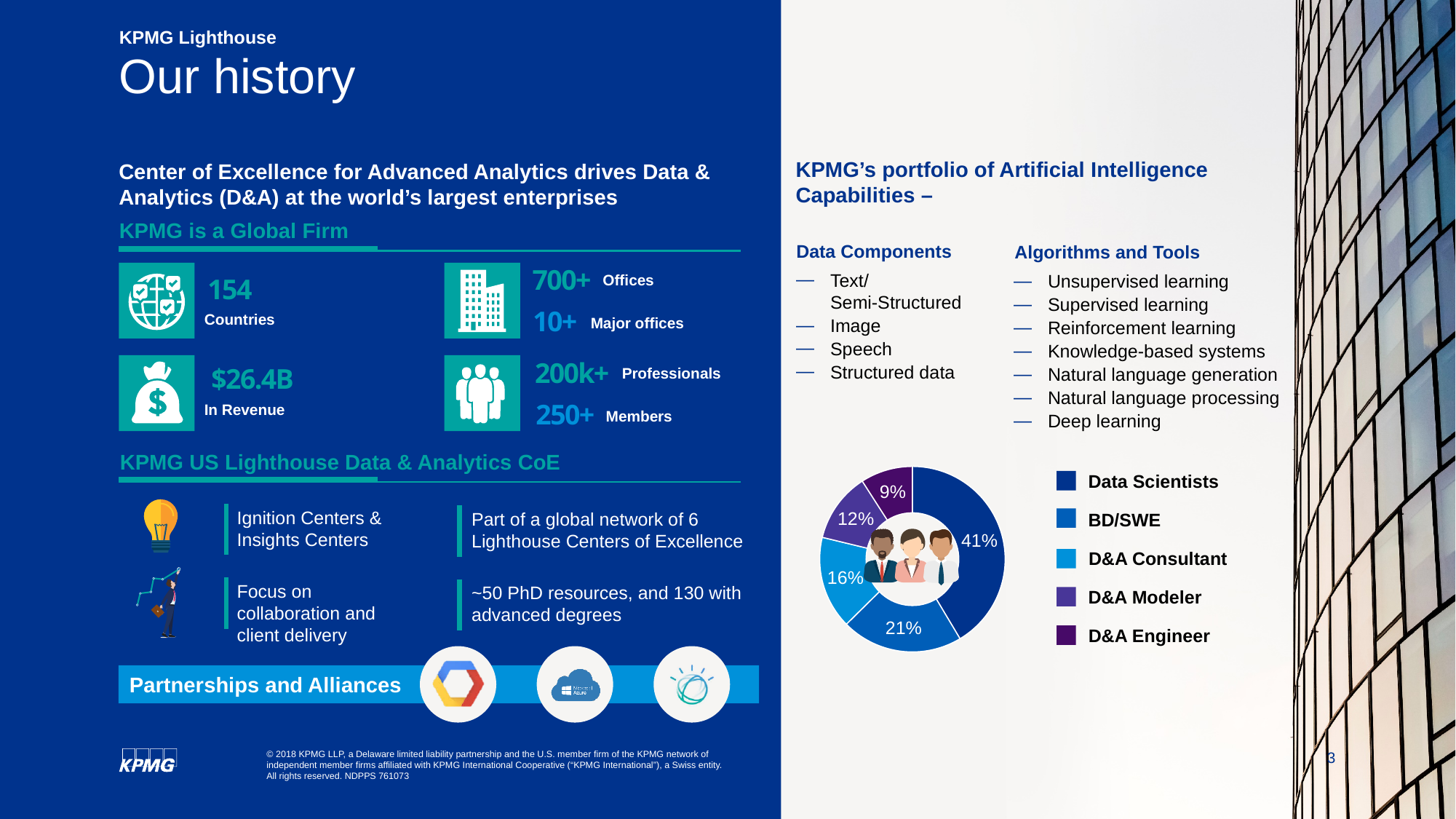
What share of the pie chart is D&A Engineer? 9% Which legend entry is shown in the darkest purple colour in the pie chart? D&A Engineer What share of the pie chart is BD/SWE? 21% Which slice is larger in the pie chart, D&A Consultant or D&A Modeler? D&A Consultant What share of the pie chart is D&A Consultant? 16% Which category has the smallest slice in the pie chart? D&A Engineer Which category has the largest slice in the pie chart? Data Scientists What is the difference in percentage points between the Data Scientists slice and the BD/SWE slice? 20 What kind of chart is shown on the slide? Doughnut chart What share of the pie chart is Data Scientists? 41% What share of the pie chart is D&A Modeler? 12% How many categories does the pie chart show? 5